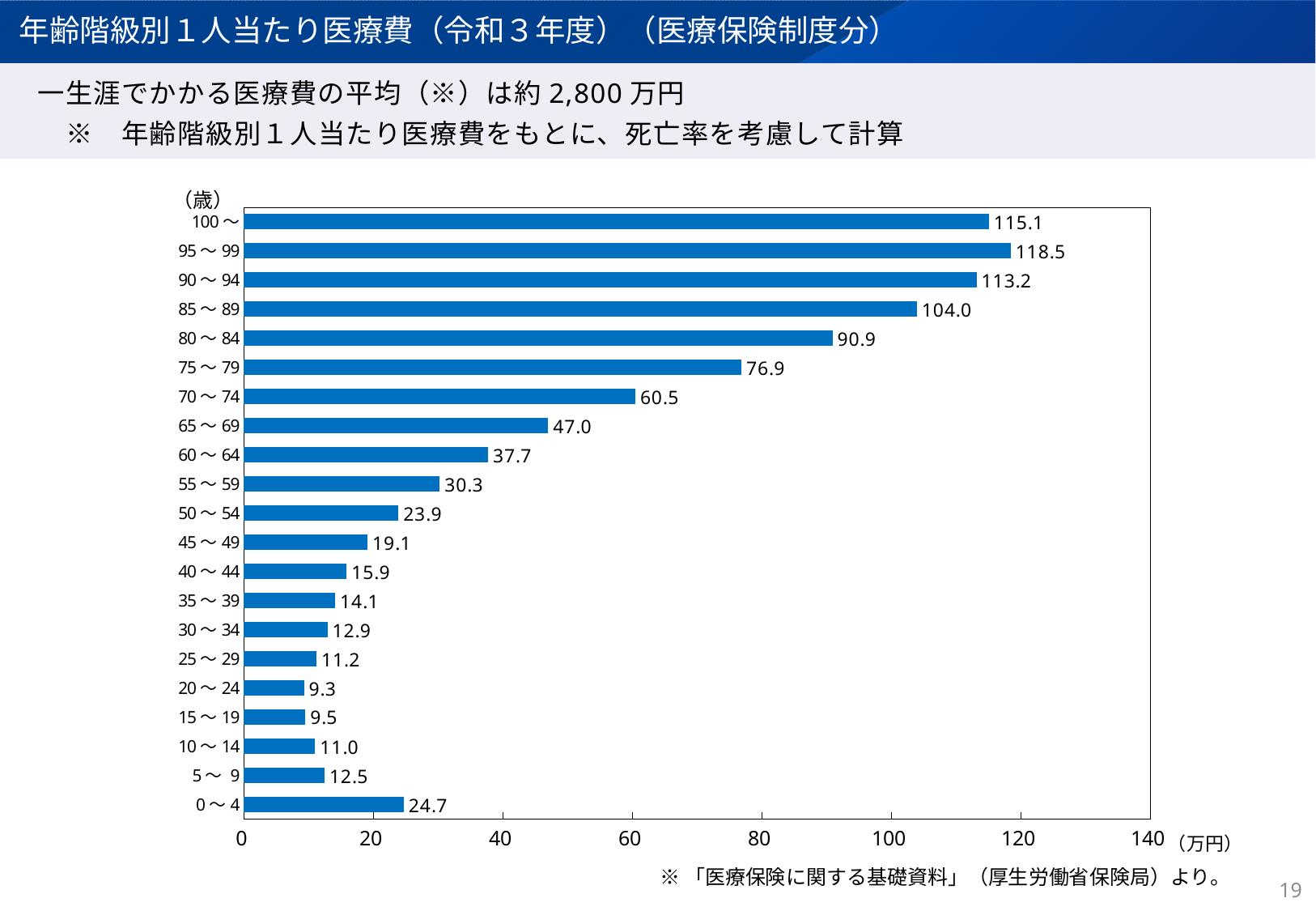
What is the difference between the values for the 95～99 and 90～94 age groups? 5.3 How many age groups are plotted in the chart? 21 Which age group has the highest per-capita medical expense? 95～99 Which is larger, the value for 80～84 or the value for 75～79? 80～84 What value is shown for the 0～4 age group? 24.7 What kind of chart is shown on the slide? Bar chart What unit is shown at the end of the horizontal axis? 万円 Which age group has the lowest per-capita medical expense? 20～24 What is the per-capita medical expense for the 85～89 age group? 104.0 What is the difference between the values for the 0～4 and 5～9 age groups? 12.2 Is the value for the 85～89 age group greater or less than 100? greater What is the value for the 65～69 age group? 47.0